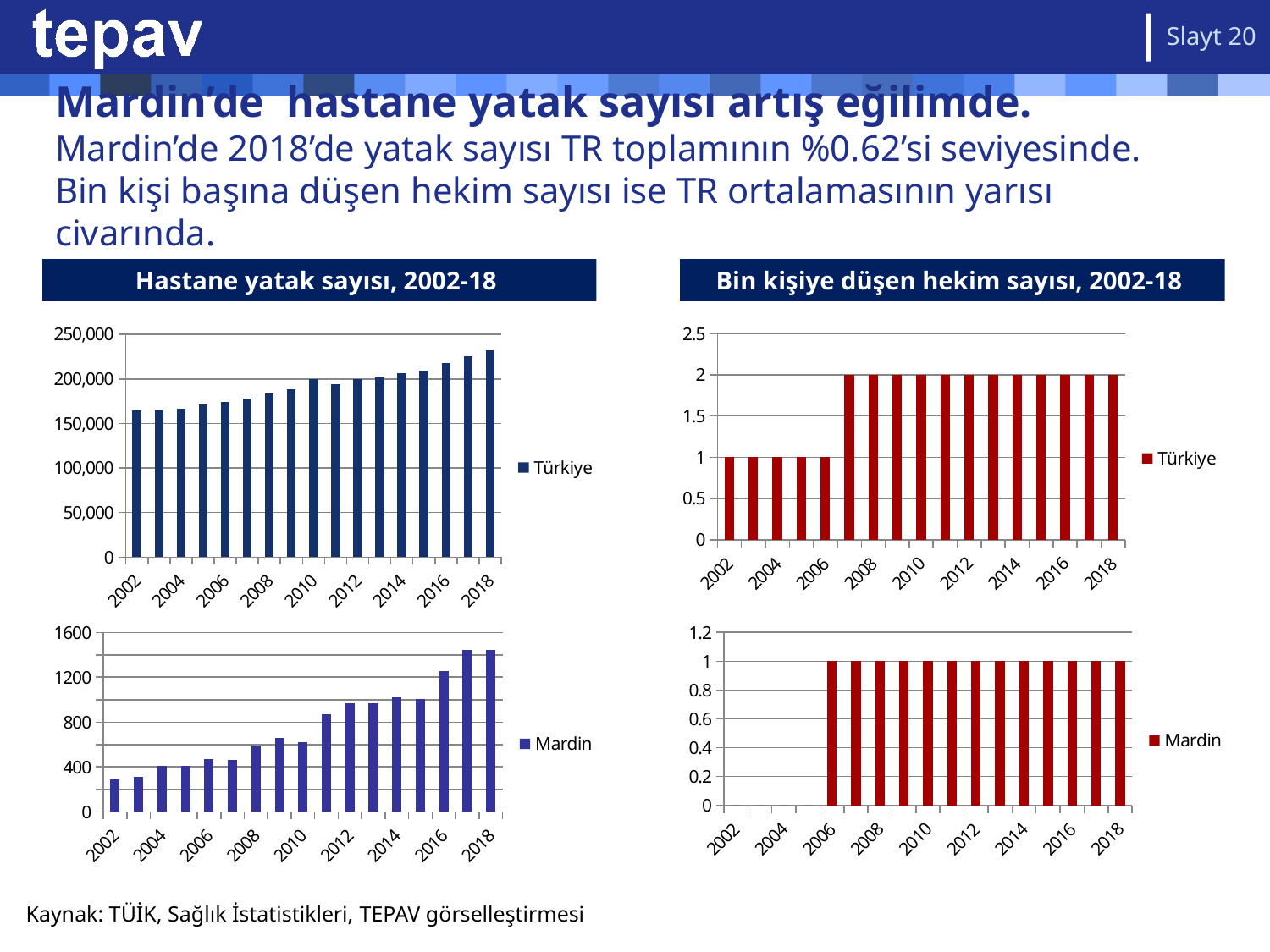
In the top-left chart (Türkiye hospital beds), do the values rise or fall from 2002 to 2018? rise In the top-right chart (Türkiye doctors per thousand people), what is the value for 2010? 2 What kind of chart is the top-left chart under "Hastane yatak sayısı, 2002-18"? bar chart What is the title of the right-hand pair of charts? Bin kişiye düşen hekim sayısı, 2002-18 In the top-left chart (Türkiye hospital beds), how many years are shown on the x axis? 17 In the bottom-left chart (Mardin hospital beds), is the value for 2018 greater or less than 1200? greater In the top-left chart (Türkiye hospital beds), is the value for 2002 greater or less than 200,000? less How many series does the legend of the bottom-left chart list? 1 In the top-left chart (Türkiye hospital beds), is the value for 2018 greater or less than 200,000? greater In the top-right chart (Türkiye doctors per thousand people), what is the value for 2004? 1 In the bottom-right chart (Mardin doctors per thousand people), what is the value for 2012? 1 In the bottom-left chart (Mardin hospital beds), which year has the lowest value? 2002